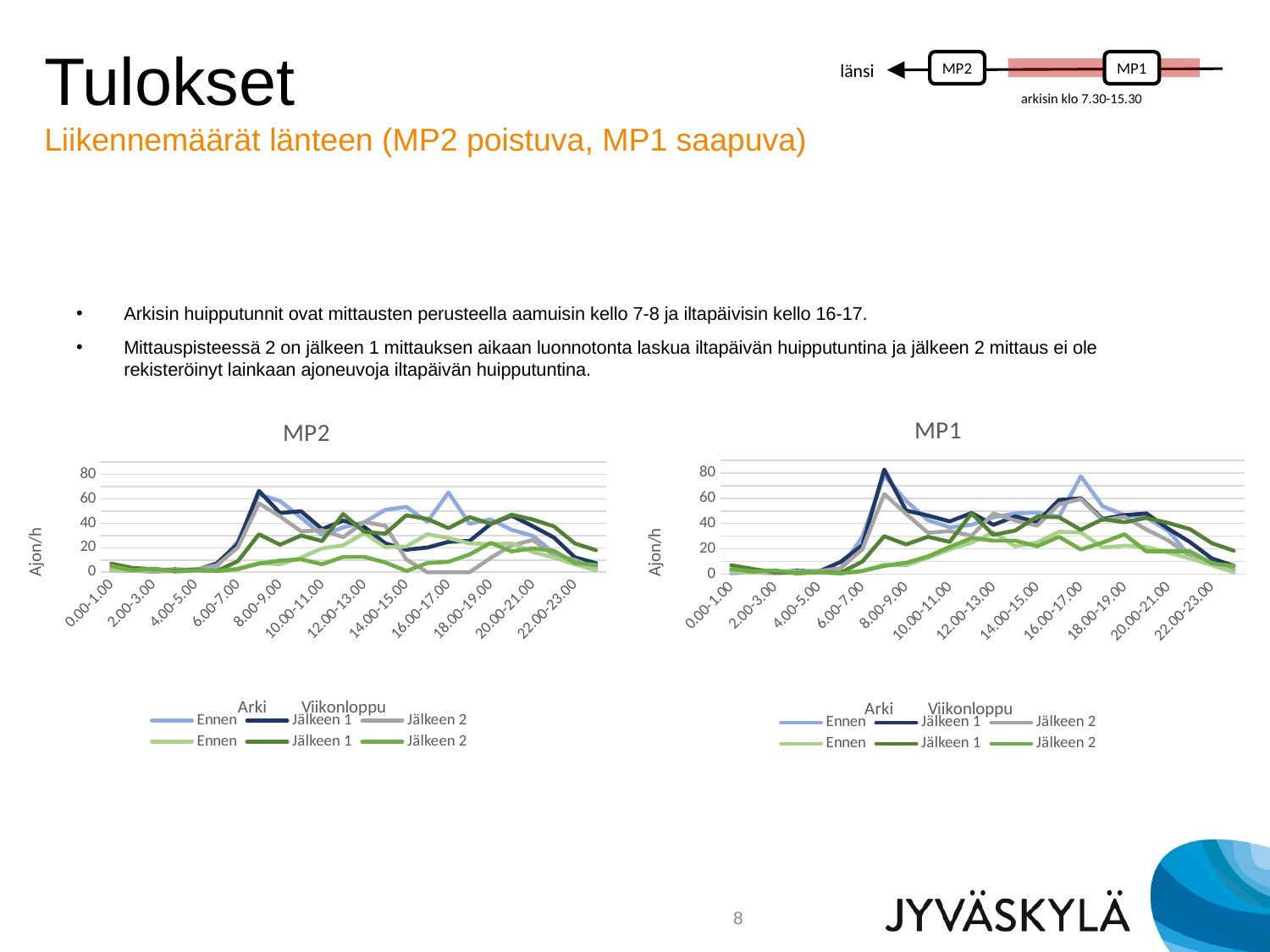
In the MP1 chart, do the Arki Jälkeen 1 values rise or fall from 4.00-5.00 to 8.00-9.00? rise In the MP2 chart, is the Arki Jälkeen 1 value at 8.00-9.00 greater or less than 40? greater How many series does the legend of the MP2 chart list? 6 In the MP1 chart, which two groups are the legend series divided into? Arki and Viikonloppu What type of chart is the MP1 chart? Line chart In the MP1 chart, is the Arki Jälkeen 1 value at 8.00-9.00 greater or less than 60? less What is the y-axis title of the MP2 chart? Ajon/h What type of chart is the MP2 chart? Line chart In the MP2 chart, is the Arki Ennen value at 16.00-17.00 greater or less than 40? greater How many series does the legend of the MP1 chart list? 6